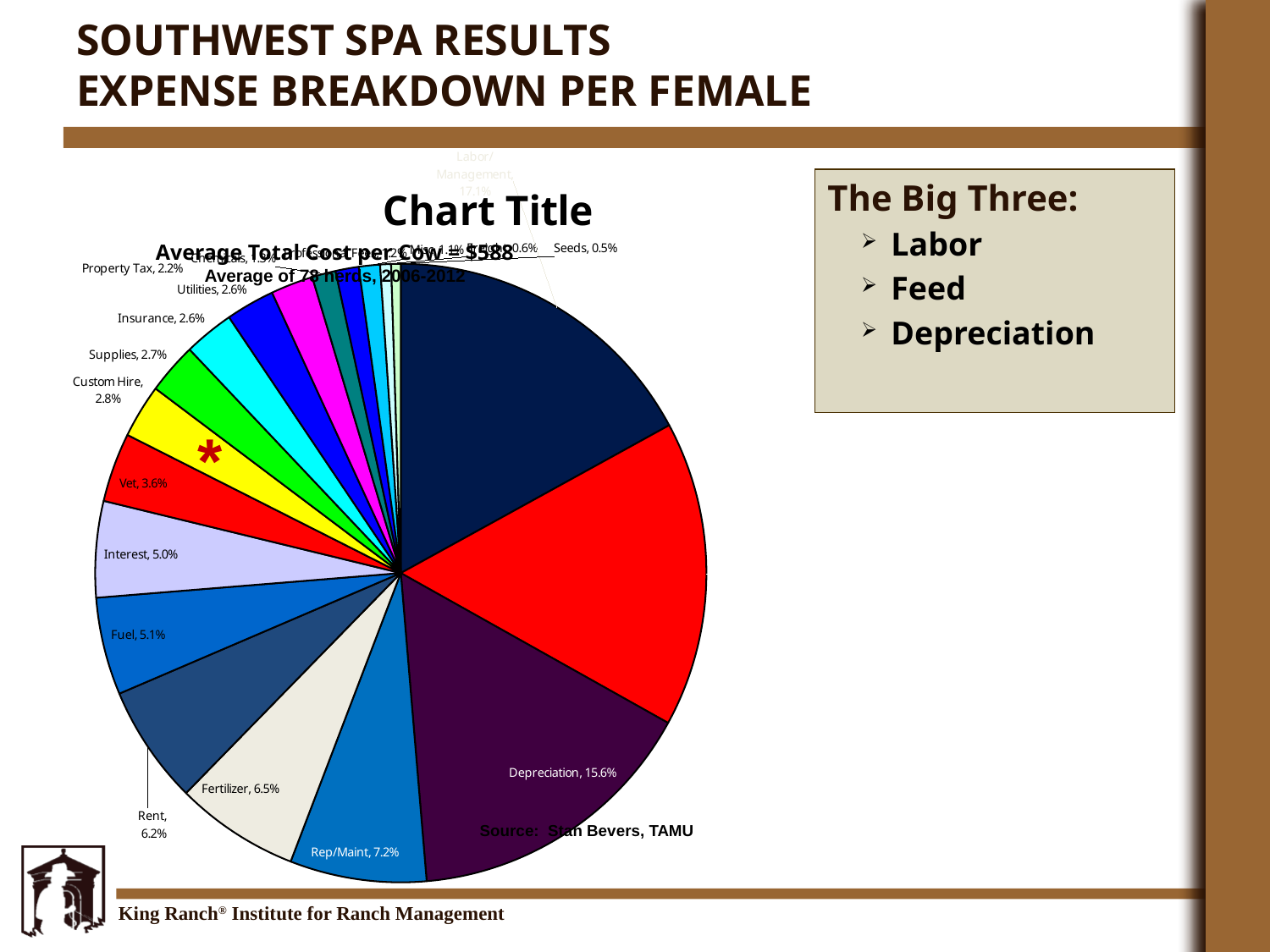
What is the value shown for Fertilizer? 6.5% What share of the pie is labelled Rep/Maint? 7.2% What percentage is shown for Rent? 6.2% What percentage does Interest account for? 5.0% Which is larger, Fertilizer or Rent? Fertilizer What kind of chart is shown on the slide? Pie chart How many percentage points larger is Depreciation than Rep/Maint? 8.4 percentage points What is the value shown for Vet? 3.6% What is the value for Fuel in the pie chart? 5.1% What percentage of the expense breakdown is Depreciation? 15.6% What percentage is shown for Seeds? 0.5% What title is printed above the pie chart? Chart Title